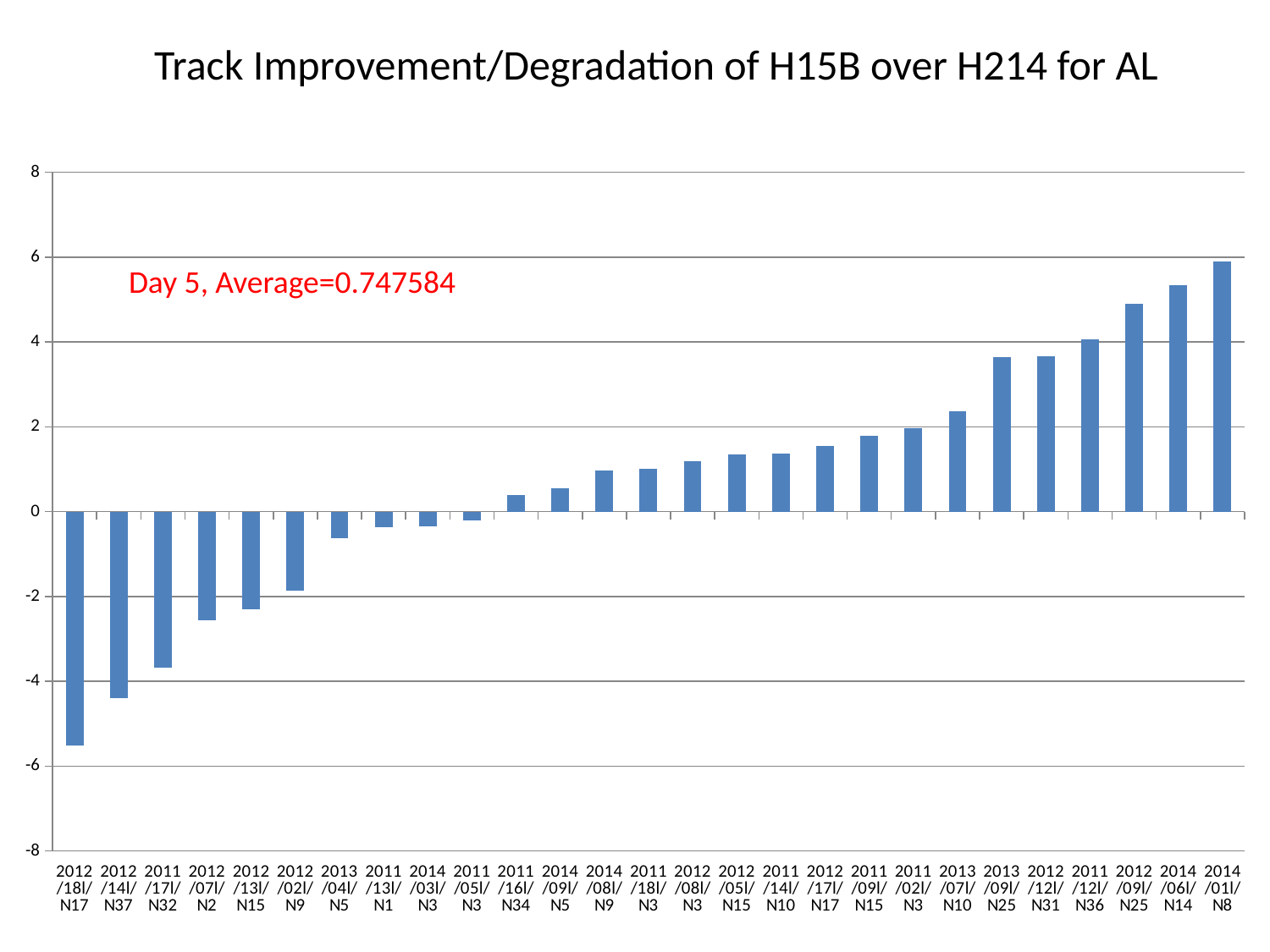
Which category has the highest value in the chart? 2014/01l/N8 Is the value for 2012/07l/N2 greater or less than -2? less What average value is stated in the red annotation on the chart? 0.747584 What kind of chart is shown on the slide? bar chart Which category has the lowest value in the chart? 2012/18l/N17 Do the bar values rise or fall from left to right along the x axis? rise Which has the larger value, 2014/06l/N14 or 2012/09l/N25? 2014/06l/N14 Is the value for 2014/01l/N8 greater or less than 4? greater Is the value for 2012/18l/N17 greater or less than -4? less What is the title of the chart? Track Improvement/Degradation of H15B over H214 for AL How many bars are plotted in the chart? 27